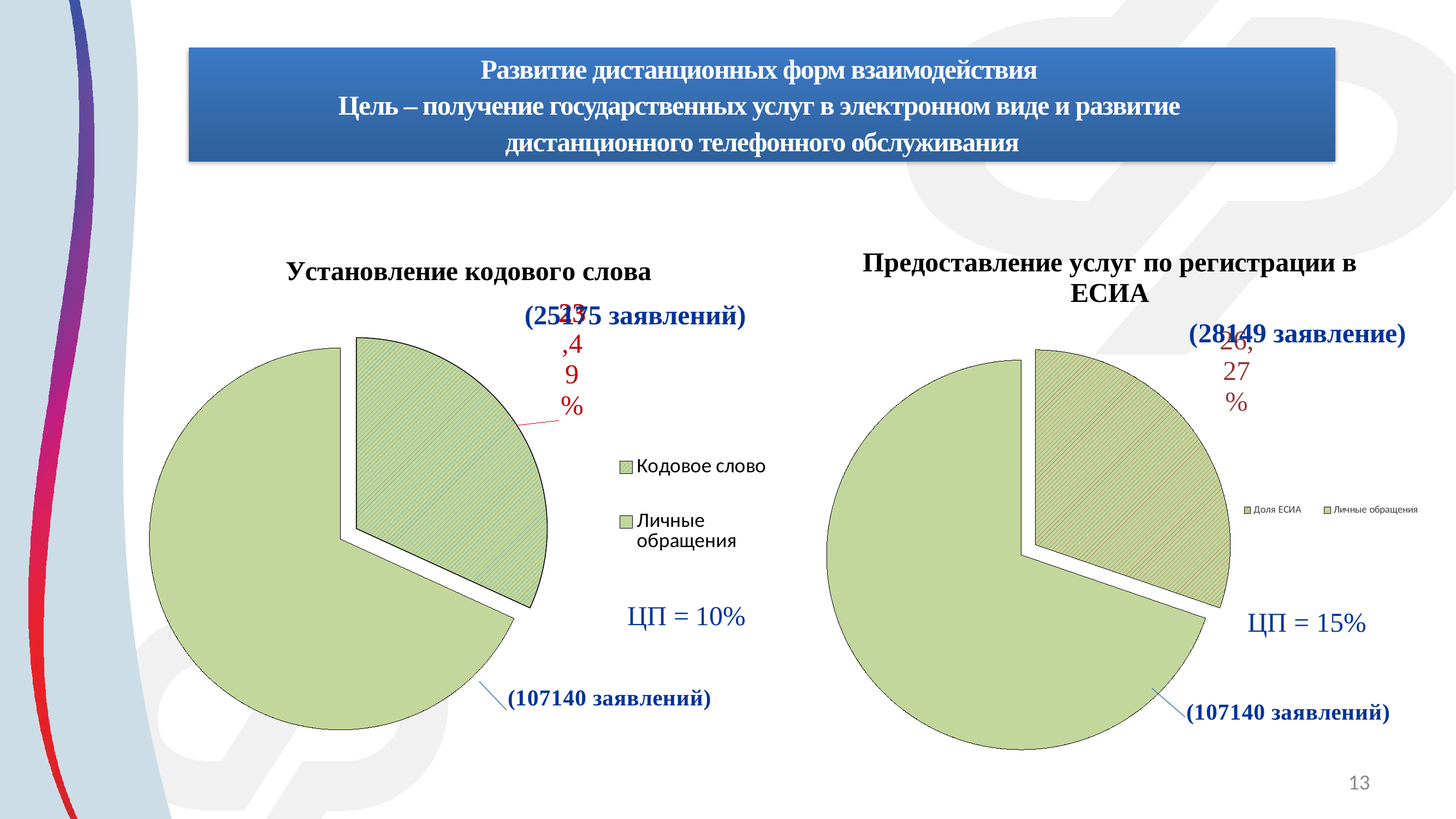
In the 'Предоставление услуг по регистрации в ЕСИА' chart, what are the two legend entries? Доля ЕСИА, Личные обращения In the 'Предоставление услуг по регистрации в ЕСИА' chart, how many entries does the legend list? 2 What kind of chart is the 'Предоставление услуг по регистрации в ЕСИА' chart? pie chart In the 'Установление кодового слова' chart, how many заявлений are labelled for the Личные обращения slice? 107140 заявлений In the 'Установление кодового слова' chart, which slice is the largest? Личные обращения What ЦП value is shown next to the 'Установление кодового слова' chart? ЦП = 10% In the 'Установление кодового слова' chart, which slice is the smallest? Кодовое слово In the 'Установление кодового слова' chart, how many slices does the pie have? 2 In the 'Установление кодового слова' chart, how many entries does the legend list? 2 In the 'Предоставление услуг по регистрации в ЕСИА' chart, which is larger: Доля ЕСИА or Личные обращения? Личные обращения What kind of chart is the 'Установление кодового слова' chart? pie chart In the 'Предоставление услуг по регистрации в ЕСИА' chart, which slice is the smallest? Доля ЕСИА